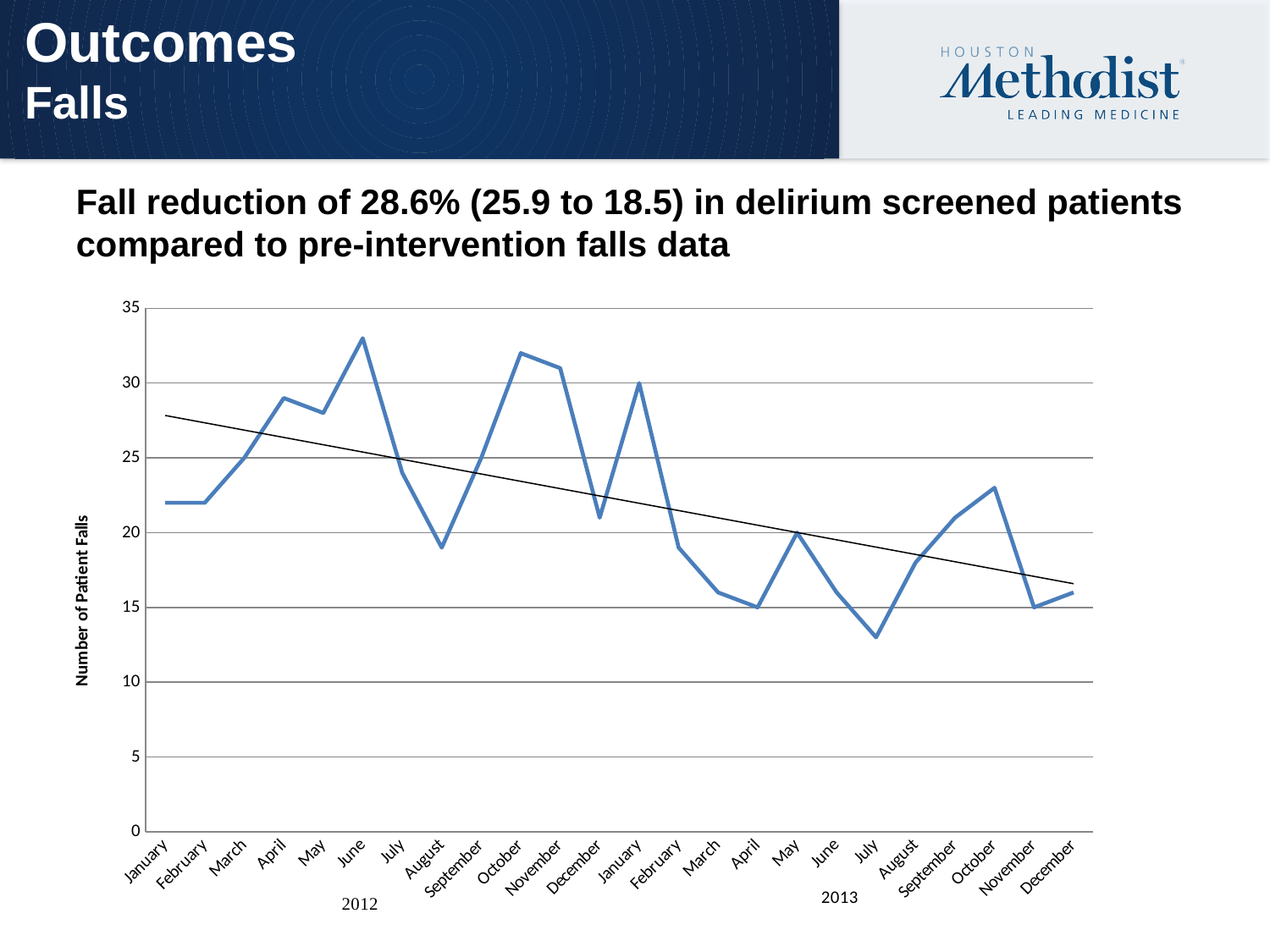
Is the value for October 2013 greater or less than 20? greater Overall, do the number of patient falls rise or fall from January 2012 to December 2013? fall Which two years are labelled along the horizontal axis? 2012 and 2013 What is the number of patient falls in May 2013? 20 Which is larger, the value for June 2012 or the value for July 2013? June 2012 Is the value for August 2012 greater or less than 25? less What kind of chart is shown on the slide? line chart Is the value for July 2013 greater or less than 15? less Which month has the lowest number of patient falls? July 2013 How many monthly data points are plotted on the chart? 24 What is the title of the vertical axis? Number of Patient Falls